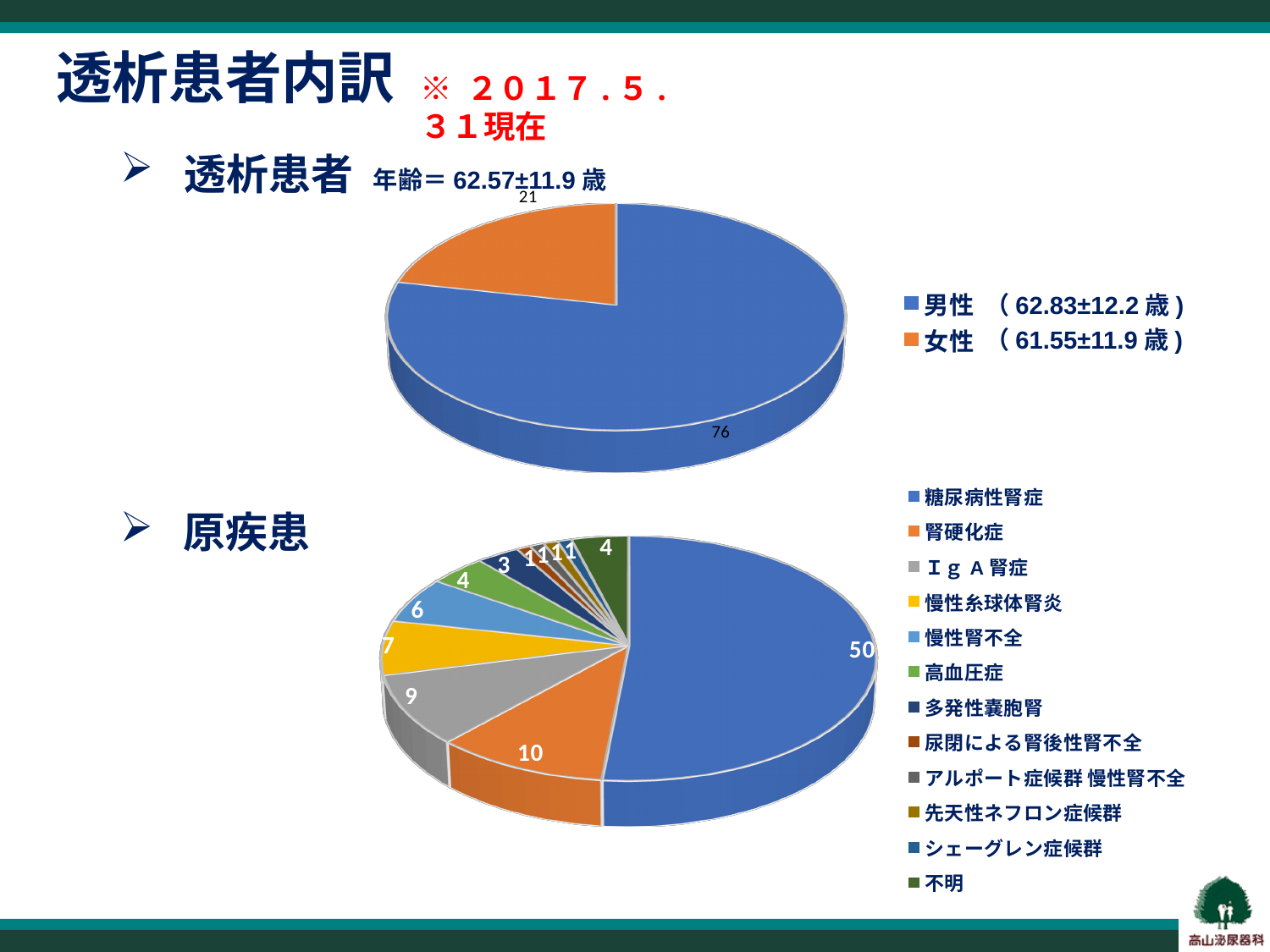
What kind of chart is the top chart (透析患者)? Pie chart In the top chart (透析患者), what is the difference between the 男性 and 女性 values? 55 In the top chart (透析患者), what is the value for 女性? 21 In the bottom chart (原疾患), what is the value for 慢性腎不全? 6 In the bottom chart (原疾患), what is the difference between 糖尿病性腎症 and 腎硬化症? 40 How many categories does the legend of the bottom chart (原疾患) list? 12 In the bottom chart (原疾患), which is larger, ＩｇＡ腎症 or 慢性糸球体腎炎? ＩｇＡ腎症 In the top chart (透析患者), what is the value for 男性? 76 In the bottom chart (原疾患), what is the value for 腎硬化症? 10 In the bottom chart (原疾患), which category has the largest value? 糖尿病性腎症 In the bottom chart (原疾患), what is the value for 糖尿病性腎症? 50 In the top chart (透析患者), what age is shown in the legend for 女性? 61.55±11.9 歳